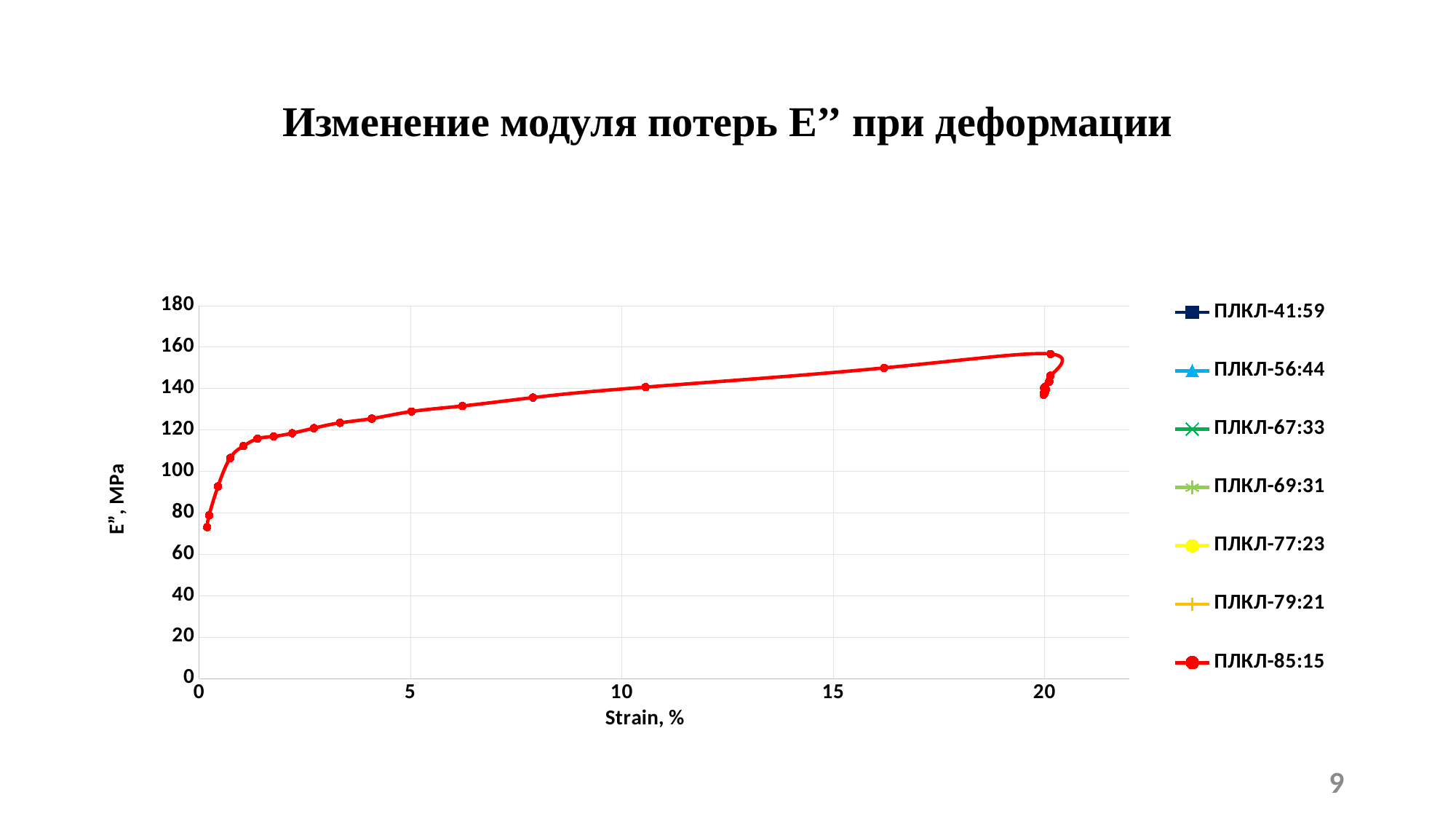
What is the label of the x axis? Strain, % How many series does the legend list? 7 Is the value of the ПЛКЛ-85:15 curve at a strain of 5% greater or less than 140? less Which legend series is plotted as the red curve? ПЛКЛ-85:15 What is the title of the chart? Изменение модуля потерь E'' при деформации Does the E'' value of the ПЛКЛ-85:15 curve rise or fall as strain increases from 0 to 20%? rise Is the value of the ПЛКЛ-85:15 curve at a strain of 15% greater or less than 160? less Is the value of the ПЛКЛ-85:15 curve at a strain of 10% greater or less than 120? greater What kind of chart is shown on the slide? line chart Which is larger for the ПЛКЛ-85:15 curve: the E'' value at 5% strain or at 15% strain? 15% strain